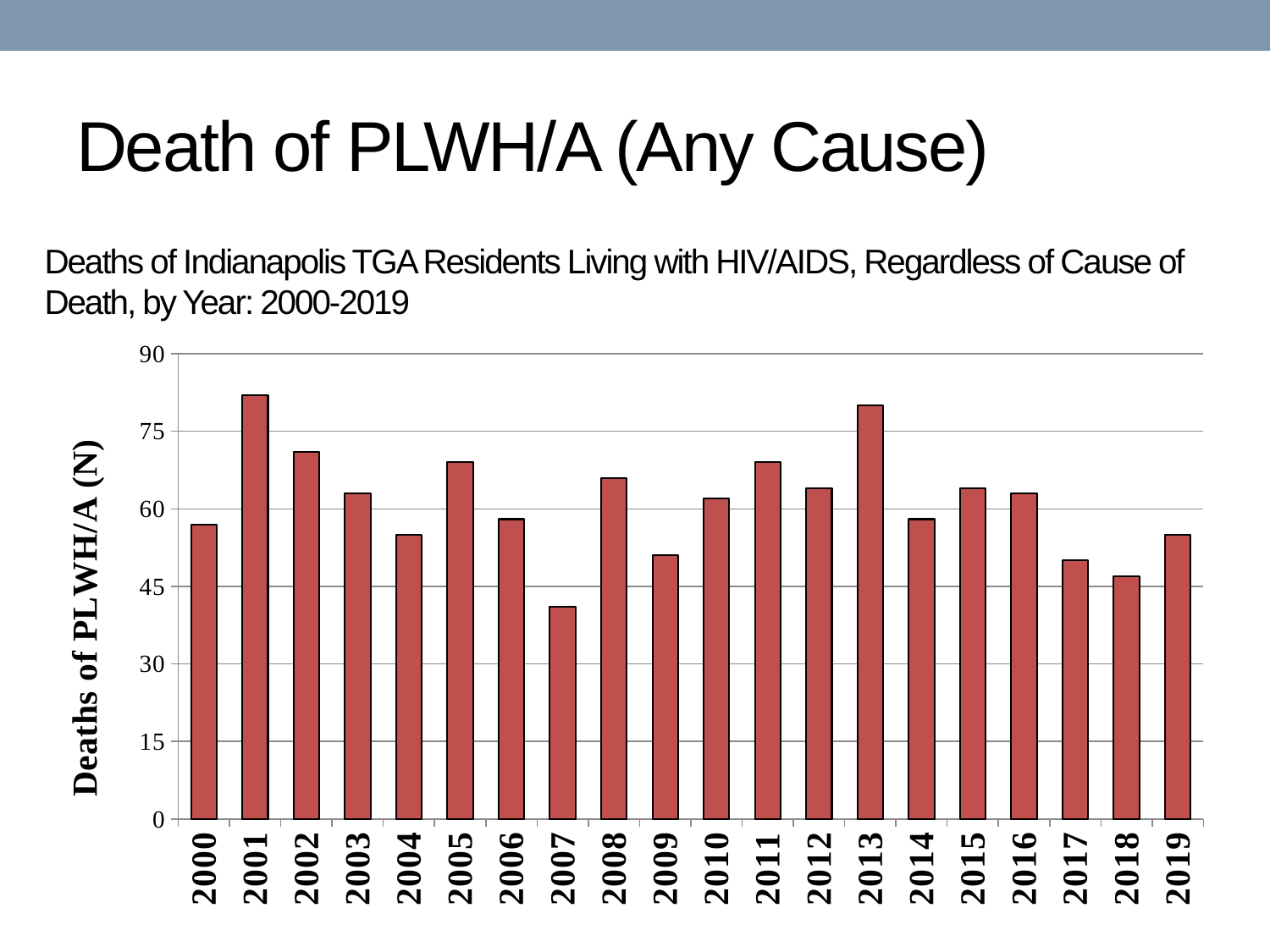
Is the value for 2013 greater or less than 75? greater Is the value for 2004 greater or less than 60? less Which year has the lowest number of deaths of PLWH/A? 2007 How many years are plotted on the x axis of the chart? 20 Is the value for 2002 greater or less than 60? greater What kind of chart is shown on the slide? bar chart Which year has the highest number of deaths of PLWH/A? 2001 Which year has more deaths, 2002 or 2003? 2002 Which year has more deaths, 2013 or 2009? 2013 What is the title of the vertical axis of the chart? Deaths of PLWH/A (N)